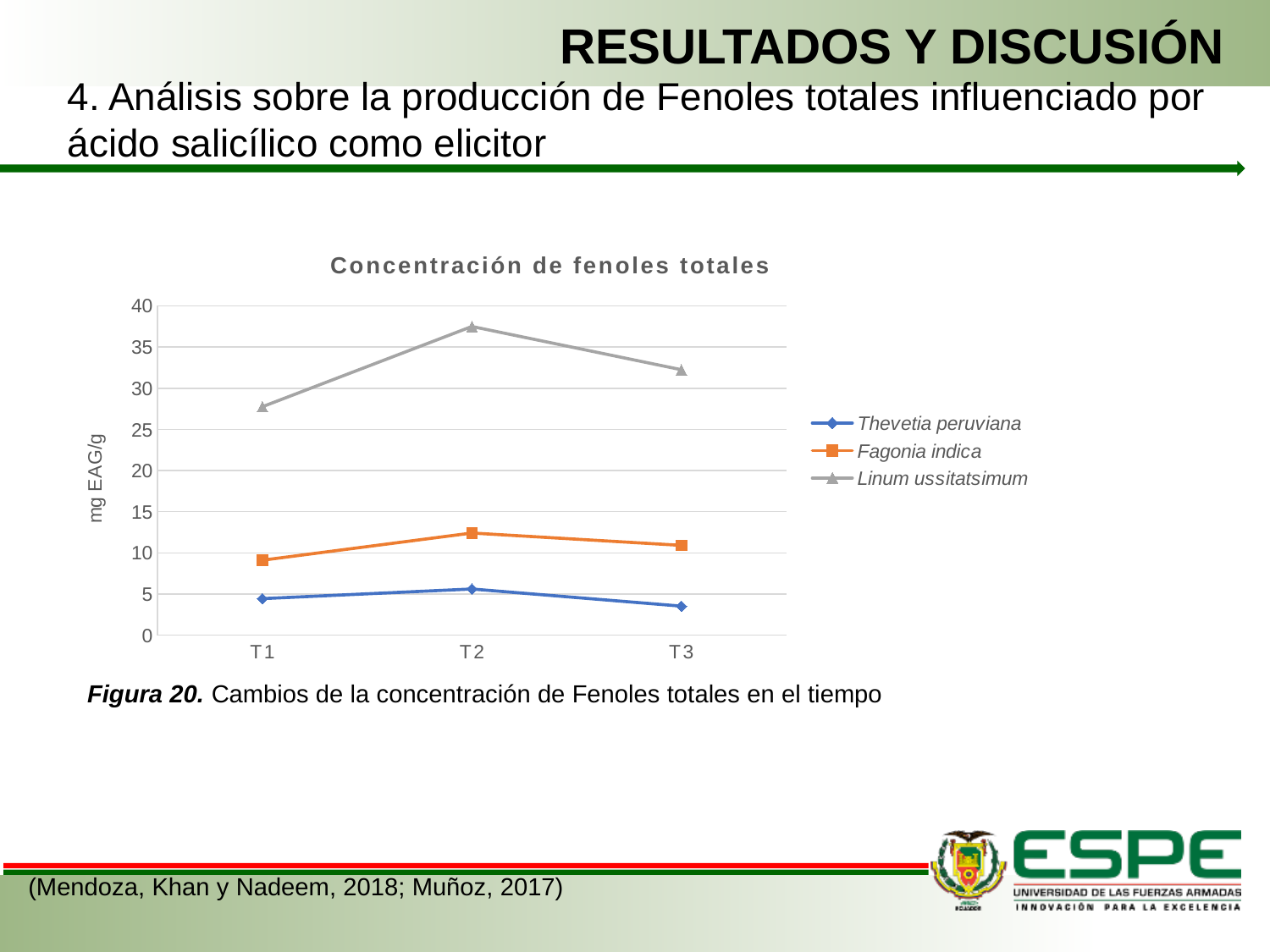
Is the value for Fagonia indica at T1 greater or less than 10? less Is the value for Linum ussitatsimum at T2 greater or less than 35? greater At which time point does Thevetia peruviana have its lowest value? T3 Which series has the highest values across all time points? Linum ussitatsimum What is the title of the chart? Concentración de fenoles totales At which time point does Linum ussitatsimum reach its highest value? T2 Which is larger at T3: Fagonia indica or Thevetia peruviana? Fagonia indica What kind of chart is shown on the slide? line chart How many series does the legend list? 3 How many time points are shown on the x axis? 3 What is the label of the y axis? mg EAG/g Does the value for Linum ussitatsimum rise or fall from T2 to T3? fall